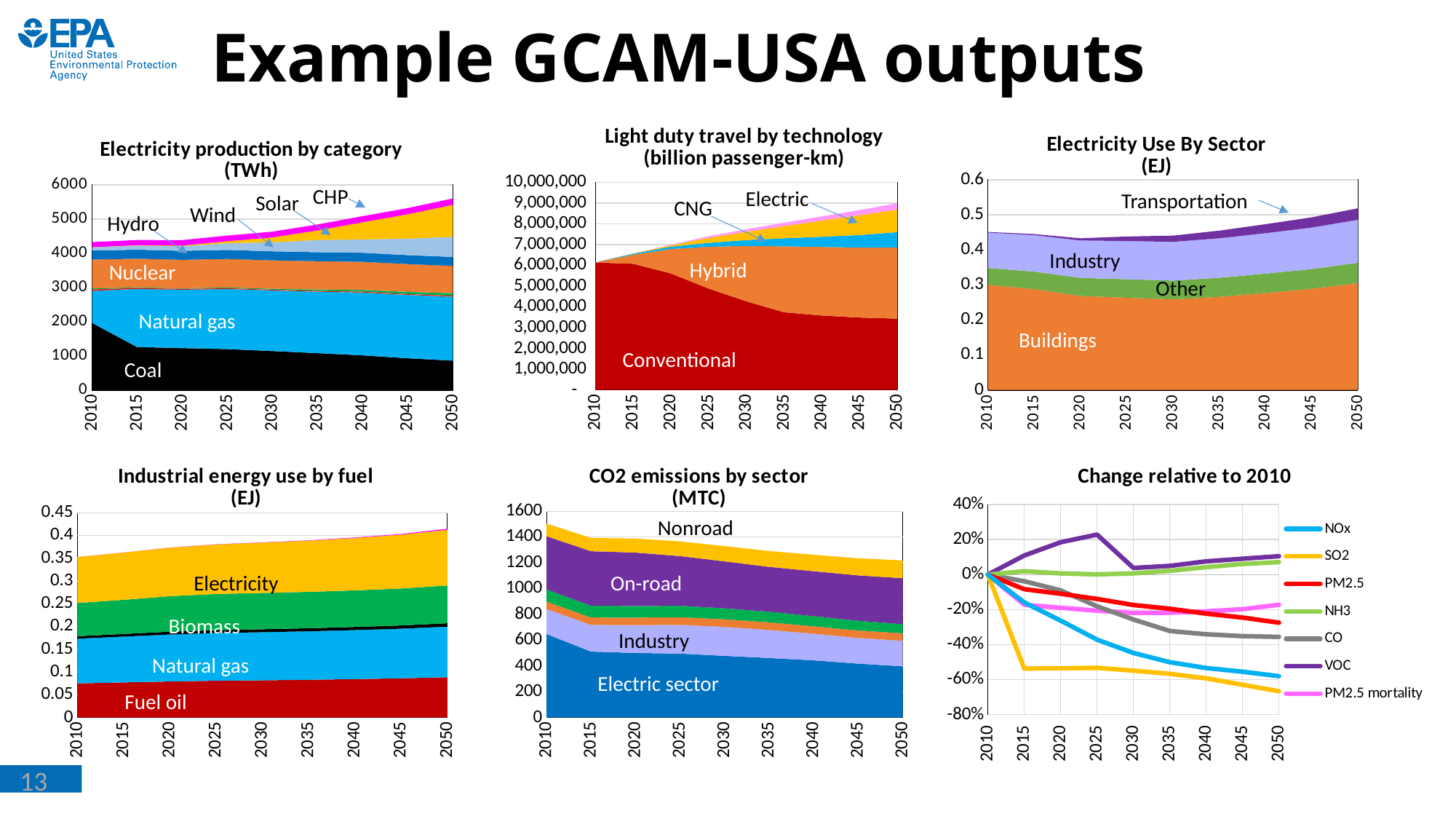
In the "Electricity production by category (TWh)" chart, is the total electricity production in 2050 greater or less than 5000? greater In the "Light duty travel by technology" chart, is the total light duty travel in 2050 greater or less than 8,000,000? greater In the "Change relative to 2010" chart, which is higher in 2050, VOC or NOx? VOC What kind of chart is the "Change relative to 2010" chart? line chart In the "Electricity Use By Sector (EJ)" chart, is the total electricity use in 2010 greater or less than 0.5? less How many years are marked on the x axis of the "Change relative to 2010" chart? 9 What kind of chart is the "Electricity production by category (TWh)" chart? area chart In the "Light duty travel by technology" chart, does the Conventional area rise or fall from 2010 to 2050? fall In the "Change relative to 2010" chart, does the SO2 line rise or fall from 2010 to 2050? fall How many series does the legend of the "Change relative to 2010" chart list? 7